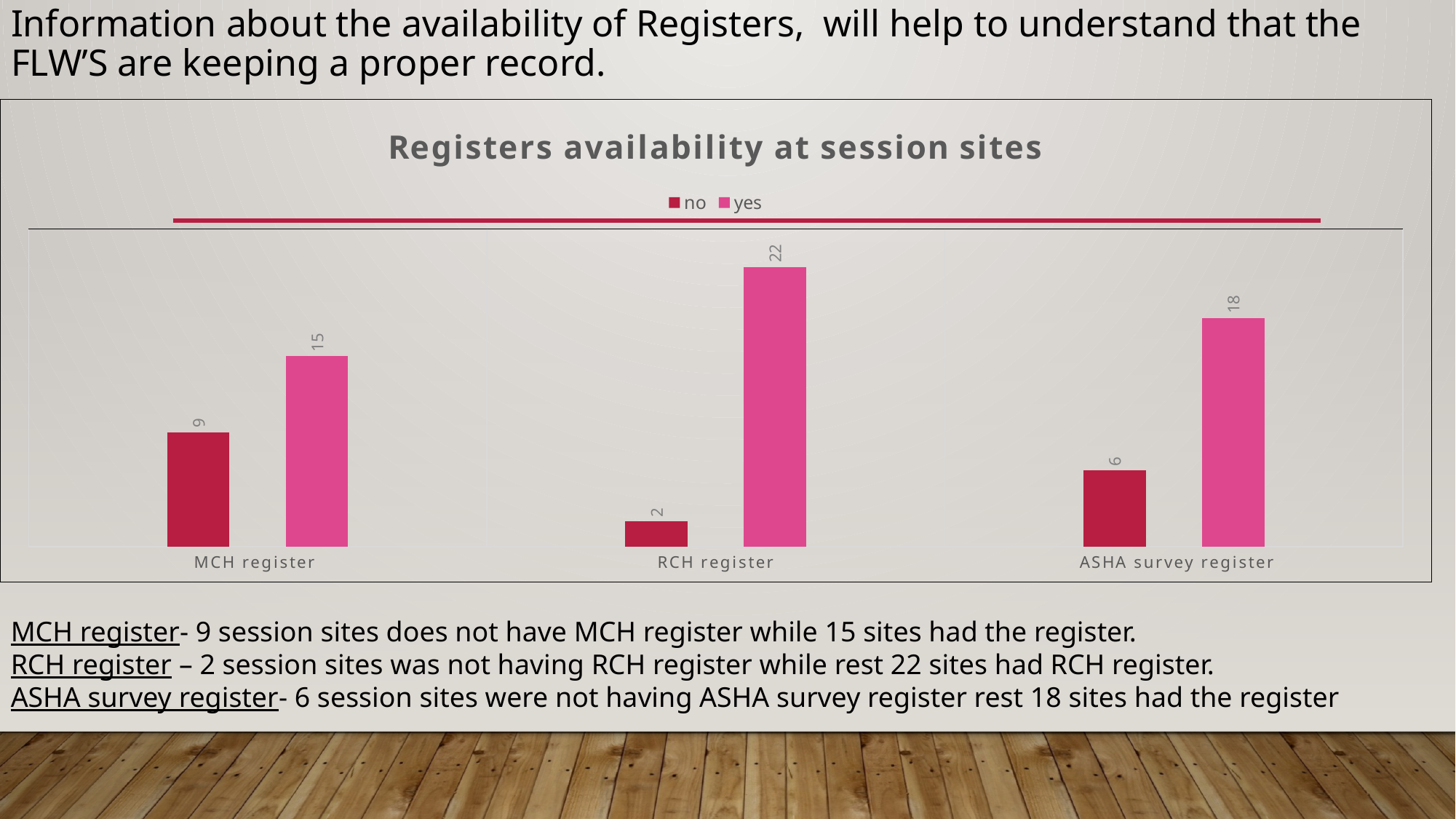
Which register has the highest 'yes' value? RCH register What is the value of the 'yes' bar for RCH register? 22 What is the value of the 'no' bar for MCH register? 9 How many series does the legend list? 2 Which is larger: the 'no' value for MCH register or the 'no' value for ASHA survey register? MCH register What kind of chart is shown on the slide? bar chart What is the title of the chart? Registers availability at session sites What is the value of the 'no' bar for ASHA survey register? 6 What is the difference between the 'yes' and 'no' values for MCH register? 6 How many register categories are shown on the x axis? 3 Which register has the lowest 'no' value? RCH register What is the difference between the 'yes' values for RCH register and ASHA survey register? 4